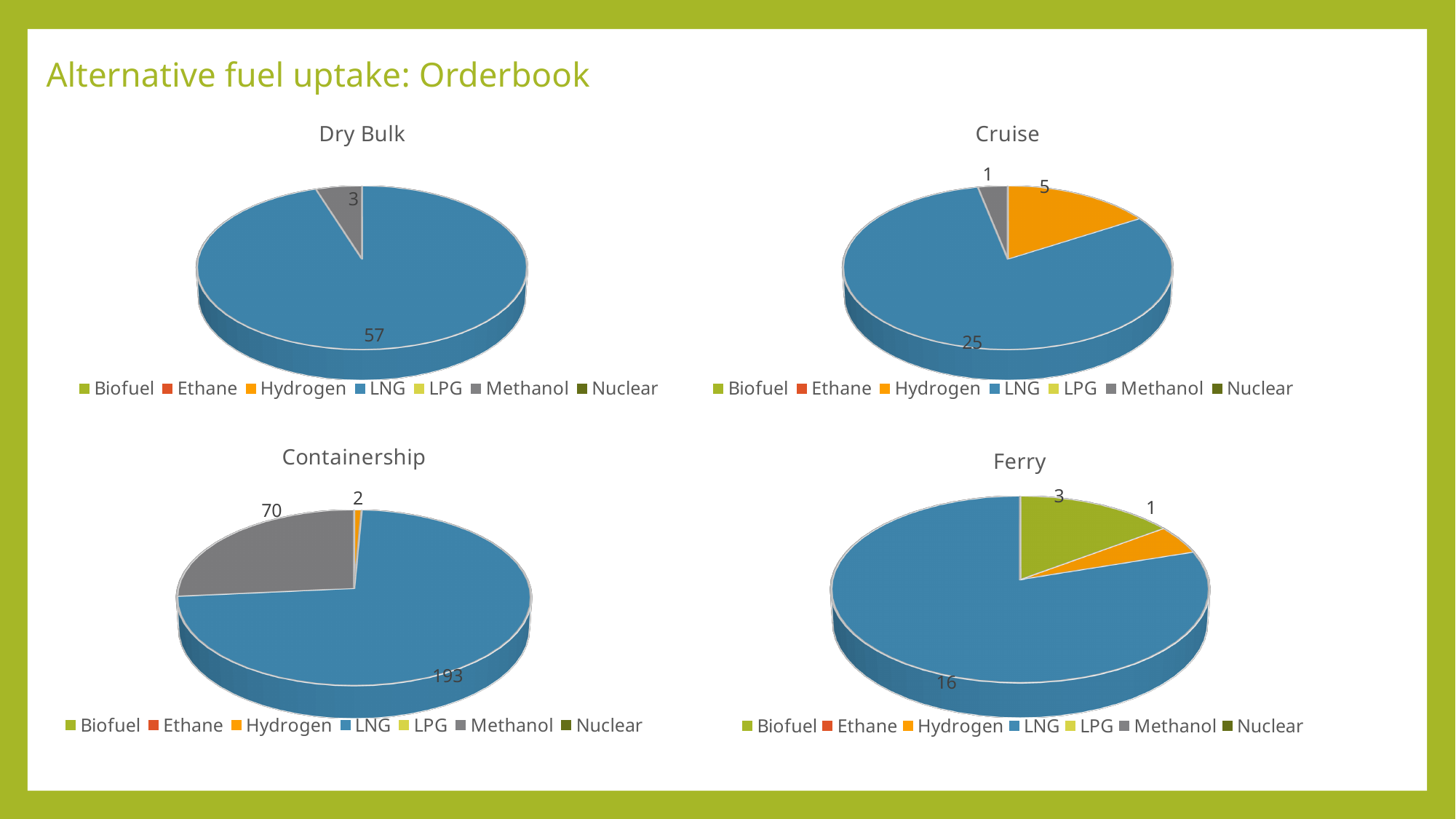
How many entries does the legend of the Dry Bulk chart list? 7 In the Containership chart, what is the difference between the LNG value and the Methanol value? 123 In the Cruise chart, what is the value for Hydrogen? 5 In the Cruise chart, which fuel has the smallest slice? Methanol What type of chart is the Cruise chart? Pie chart In the Containership chart, which fuel has the largest slice? LNG In the Ferry chart, what share of the total does LNG represent? 80% In the Containership chart, what is the value for Methanol? 70 In the Ferry chart, what is the value for Biofuel? 3 In the Dry Bulk chart, what is the value for Methanol? 3 In the Dry Bulk chart, what is the value for LNG? 57 In the Ferry chart, which is larger, the Biofuel value or the Hydrogen value? Biofuel